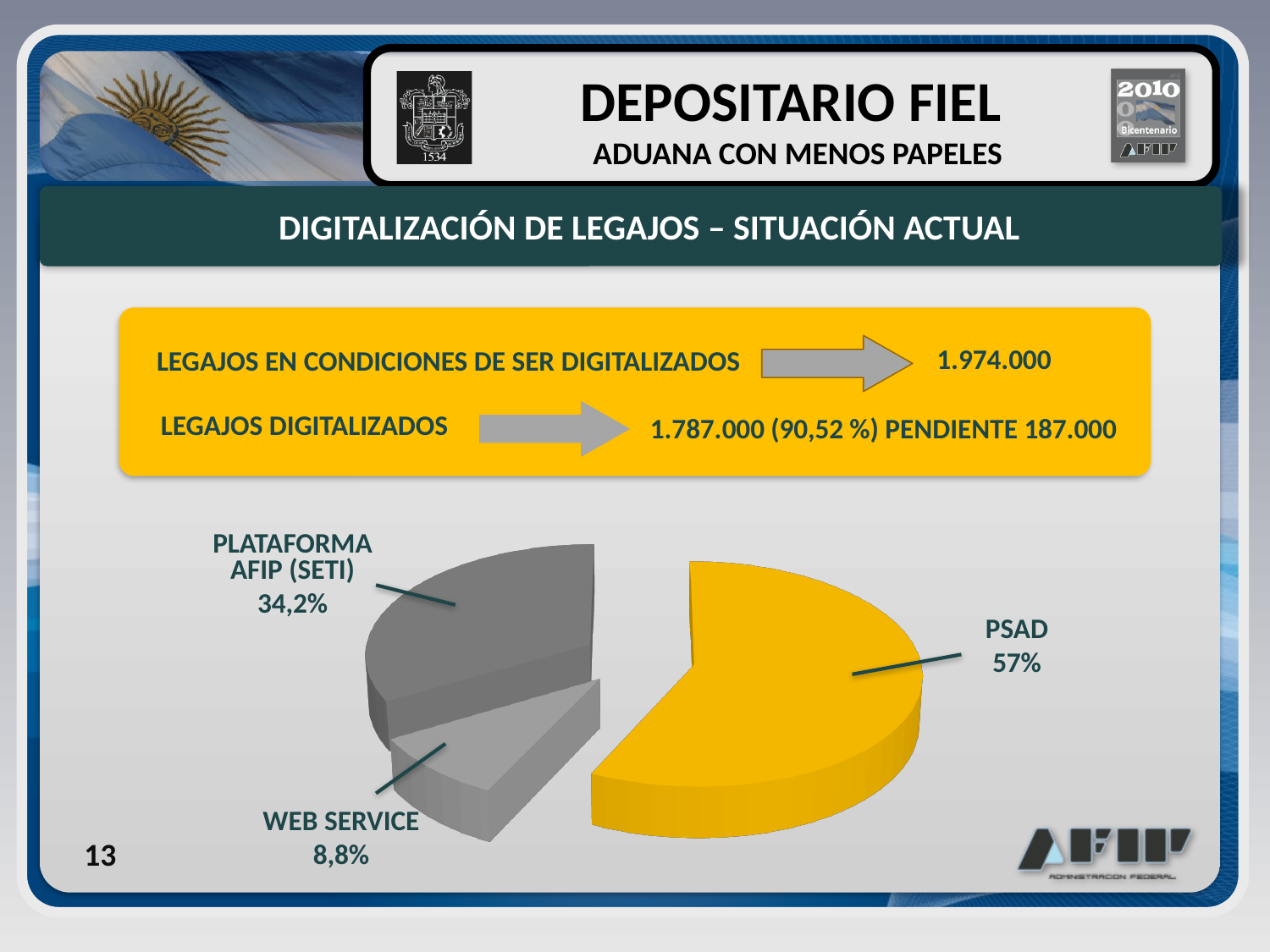
What is the difference in percentage points between the PLATAFORMA AFIP (SETI) slice and the WEB SERVICE slice? 25,4 How many slices does the pie chart have? 3 What colour is the PSAD slice of the pie chart? yellow What share of the pie does PLATAFORMA AFIP (SETI) represent? 34,2% What is the difference in percentage points between the PSAD slice and the PLATAFORMA AFIP (SETI) slice? 22,8 Is the PSAD slice greater or less than 50% of the pie? greater What share of the pie does WEB SERVICE represent? 8,8% What share of the pie does PSAD represent? 57% What kind of chart is shown on the slide? pie chart Which slice of the pie chart is the smallest? WEB SERVICE Which slice of the pie chart is the largest? PSAD Which is larger, the PLATAFORMA AFIP (SETI) slice or the WEB SERVICE slice? PLATAFORMA AFIP (SETI)